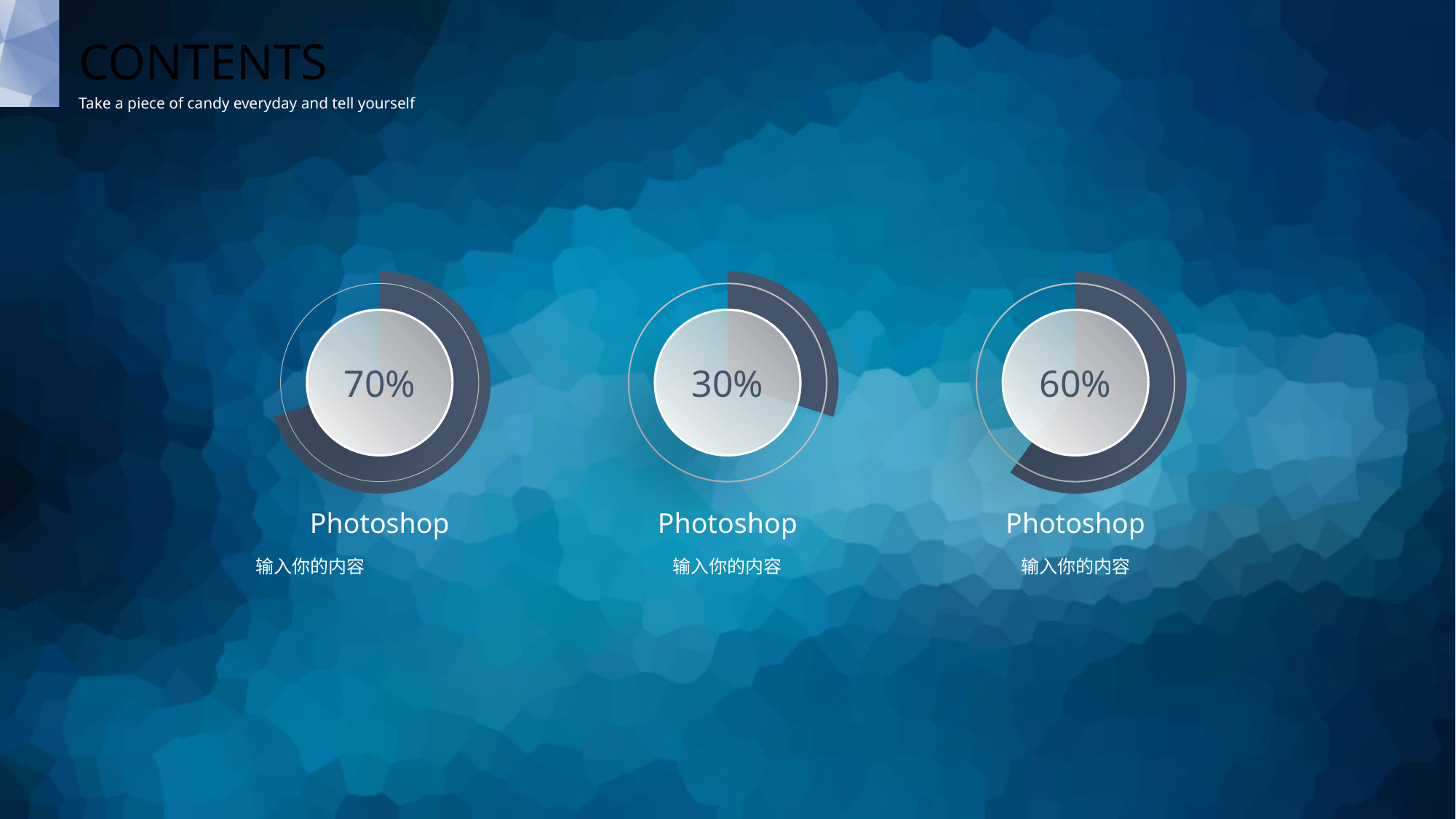
What value is shown in the left chart? 70% What is the difference between the value in the right chart and the value in the middle chart? 30% What kind of chart is used to show the percentages on the slide? donut (ring) chart How many circular percentage charts are on the slide? 3 What value is shown in the middle chart? 30% Which of the three charts shows the highest percentage: left, middle or right? left Which is larger, the value in the left chart or the value in the right chart? left chart (70%) Which of the three charts shows the lowest percentage: left, middle or right? middle What label appears beneath each of the three charts? Photoshop What is the difference between the value in the left chart and the value in the middle chart? 40% Is the value in the middle chart greater or less than 50%? less What value is shown in the right chart? 60%